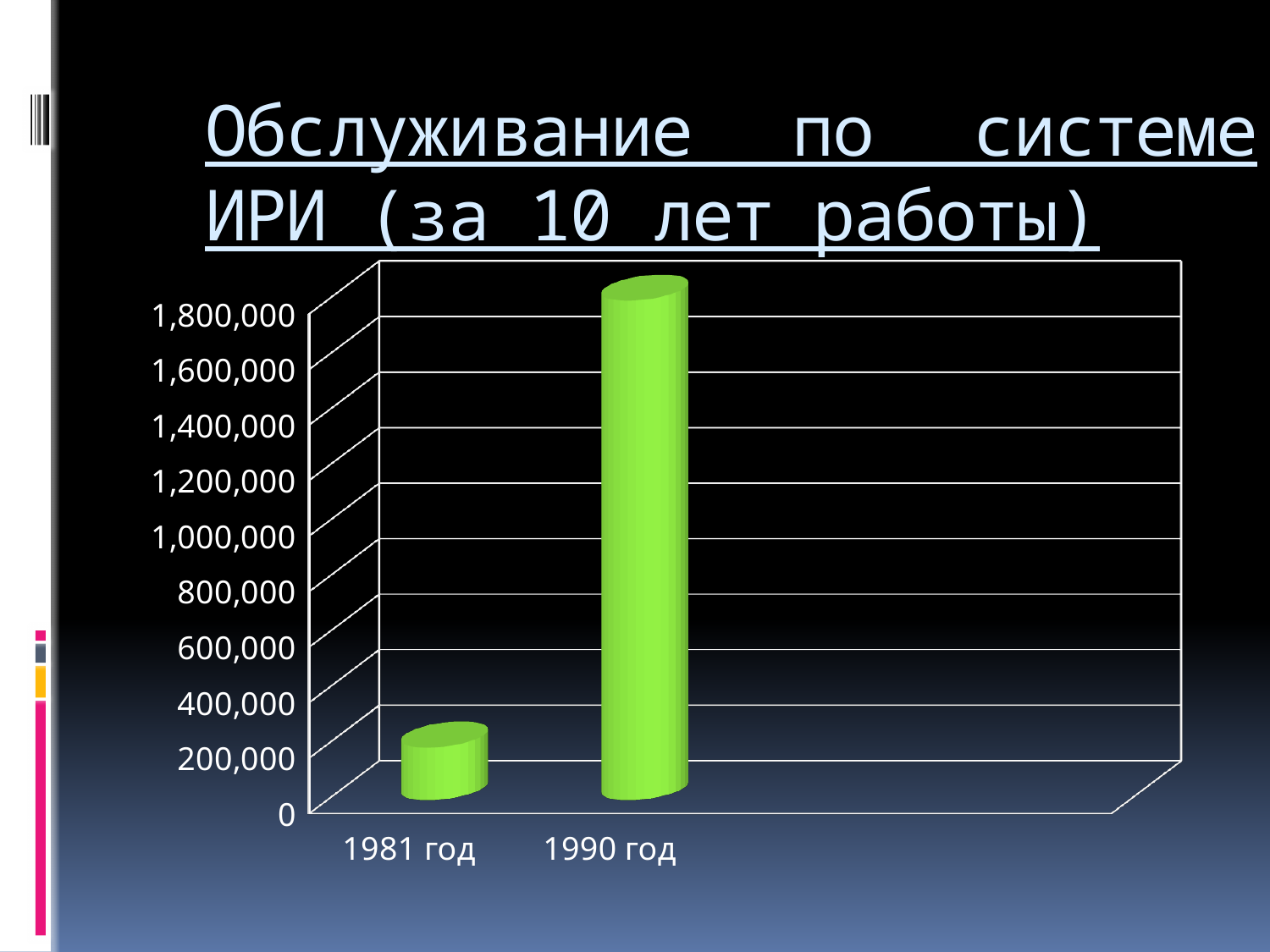
Which is larger, the value for 1981 год or the value for 1990 год? 1990 год Do the values rise or fall from 1981 год to 1990 год? rise Is the value for 1990 год greater or less than 1,600,000? greater How many categories are plotted on the chart? 2 What is the title of the slide containing the chart? Обслуживание по системе ИРИ (за 10 лет работы) Which category has the highest value on the chart? 1990 год Is the value for 1990 год greater or less than 1,000,000? greater What is the highest tick label shown on the vertical axis? 1,800,000 What kind of chart is shown on the slide? bar chart Which category has the lowest value on the chart? 1981 год Is the value for 1981 год greater or less than 400,000? less